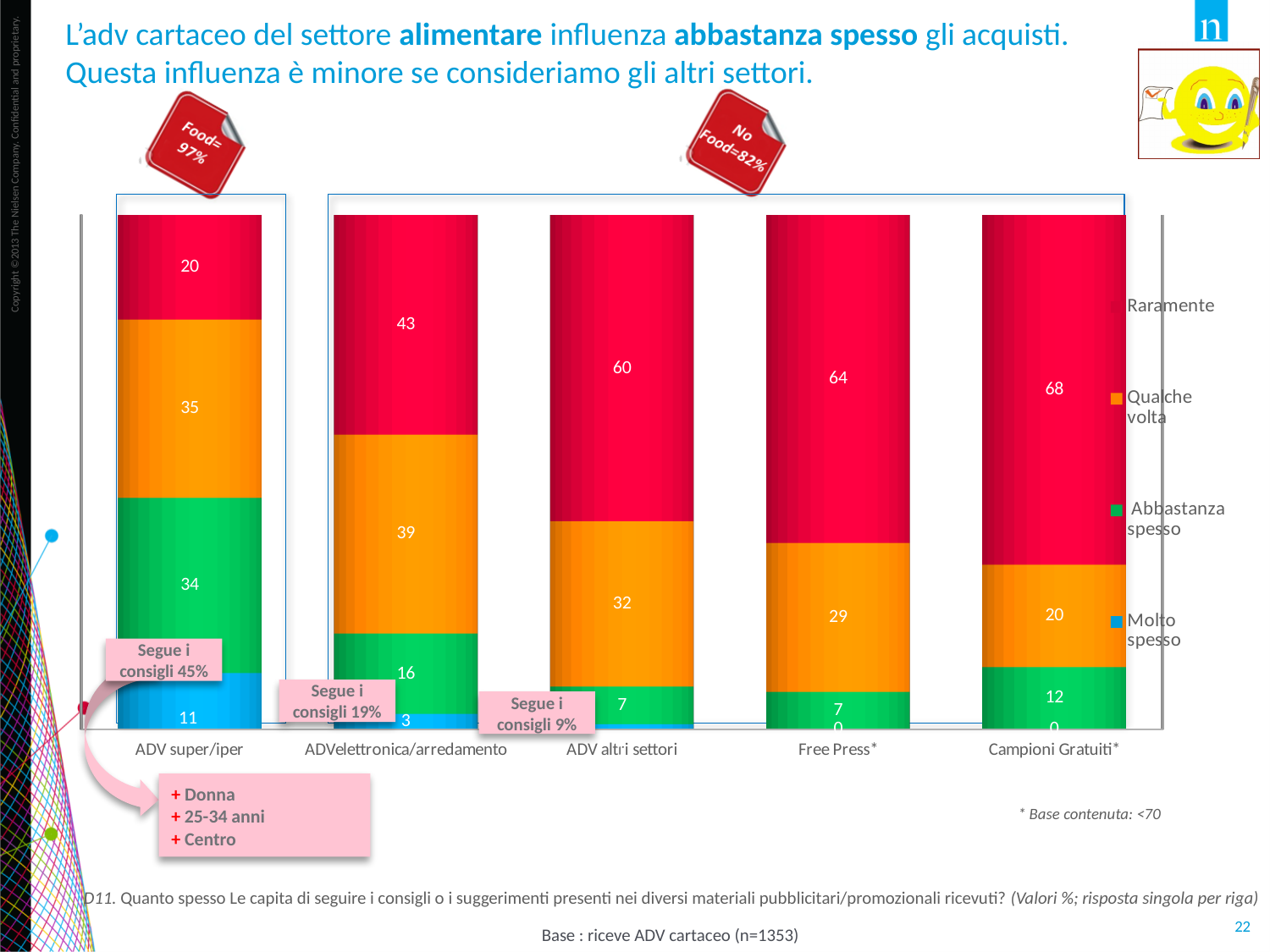
Which category has the lowest 'Qualche volta' value? Campioni Gratuiti* What is the 'Qualche volta' value for Campioni Gratuiti*? 20 What is the 'Molto spesso' value for Free Press*? 0 How many series does the chart legend list? 4 Which is larger: the 'Abbastanza spesso' value for ADV super/iper or for Campioni Gratuiti*? ADV super/iper Which category has the highest 'Raramente' value? Campioni Gratuiti* Which legend entry is shown in orange? Qualche volta What kind of chart is shown on the slide? stacked bar chart What is the 'Raramente' value for ADV super/iper? 20 What is the 'Abbastanza spesso' value for ADVelettronica/arredamento? 16 What is the difference between the 'Raramente' values for ADV altri settori and ADV super/iper? 40 How many categories are shown along the x axis of the chart? 5